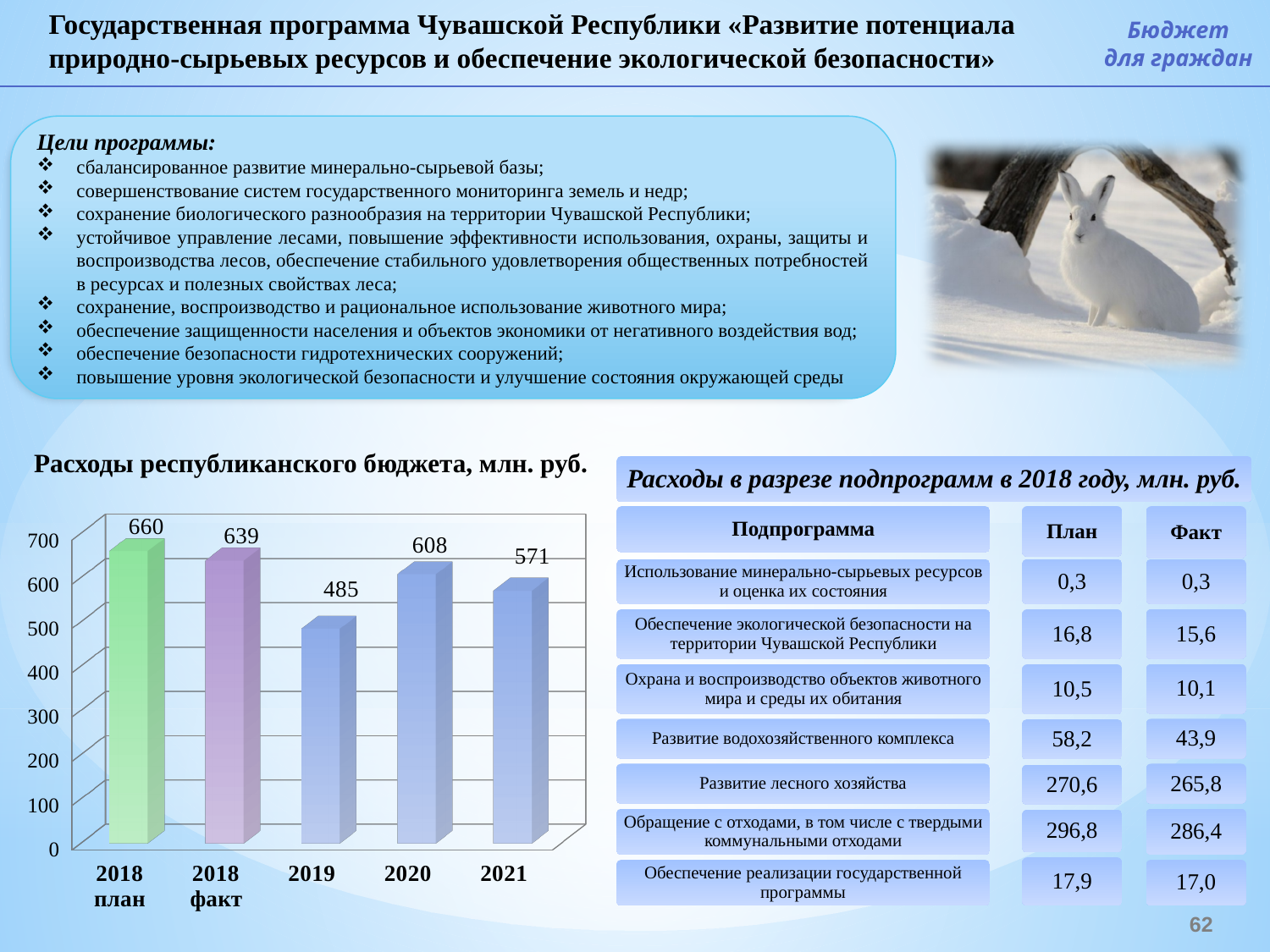
What is the value for 2018 факт in the chart 'Расходы республиканского бюджета, млн. руб.'? 639 In the chart 'Расходы республиканского бюджета, млн. руб.', do the values rise or fall from 2019 to 2020? rise What is the value for 2021 in the chart 'Расходы республиканского бюджета, млн. руб.'? 571 Which category has the lowest value in the chart 'Расходы республиканского бюджета, млн. руб.'? 2019 What is the difference between the 2020 and 2019 values in the chart 'Расходы республиканского бюджета, млн. руб.'? 123 What is the difference between the 2018 план and 2018 факт values in the chart 'Расходы республиканского бюджета, млн. руб.'? 21 Which is larger in the chart 'Расходы республиканского бюджета, млн. руб.': the value for 2020 or the value for 2021? 2020 Which category has the highest value in the chart 'Расходы республиканского бюджета, млн. руб.'? 2018 план What is the value for 2018 план in the chart 'Расходы республиканского бюджета, млн. руб.'? 660 What kind of chart is 'Расходы республиканского бюджета, млн. руб.'? bar chart What is the value for 2019 in the chart 'Расходы республиканского бюджета, млн. руб.'? 485 How many bars are shown in the chart 'Расходы республиканского бюджета, млн. руб.'? 5